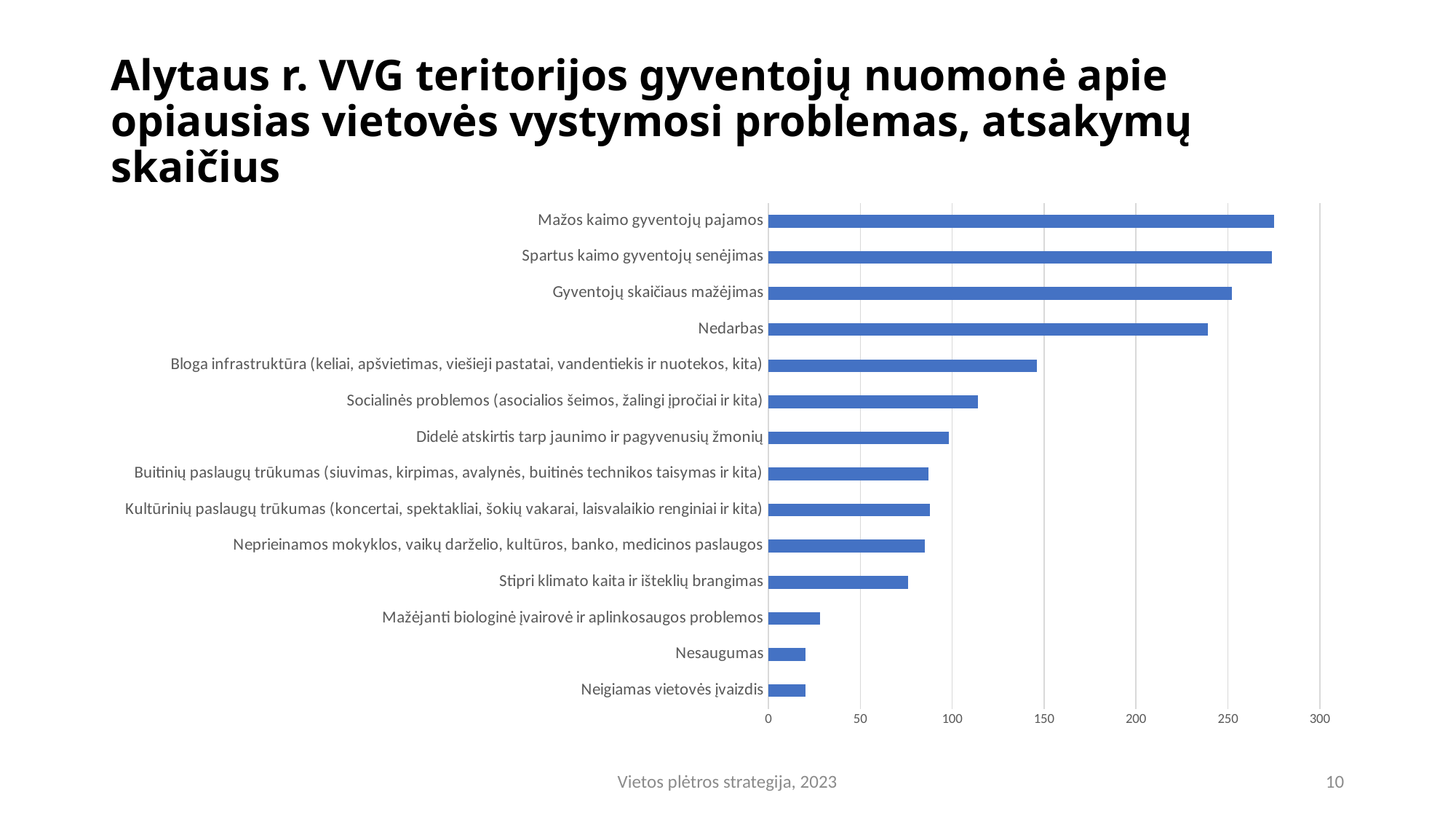
What kind of chart is shown on the slide? bar chart How many categories (problems) are listed in the chart? 14 Is the value for Nedarbas greater or less than 200? greater Is the value for Mažėjanti biologinė įvairovė ir aplinkosaugos problemos greater or less than 50? less Is the value for Nesaugumas greater or less than 50? less Do the bar values increase or decrease going from the top category to the bottom category? decrease Which has a larger value: Bloga infrastruktūra (keliai, apšvietimas, viešieji pastatai, vandentiekis ir nuotekos, kita) or Didelė atskirtis tarp jaunimo ir pagyvenusių žmonių? Bloga infrastruktūra (keliai, apšvietimas, viešieji pastatai, vandentiekis ir nuotekos, kita) What is the highest tick value shown on the horizontal axis? 300 Which has a larger value: Nedarbas or Stipri klimato kaita ir išteklių brangimas? Nedarbas